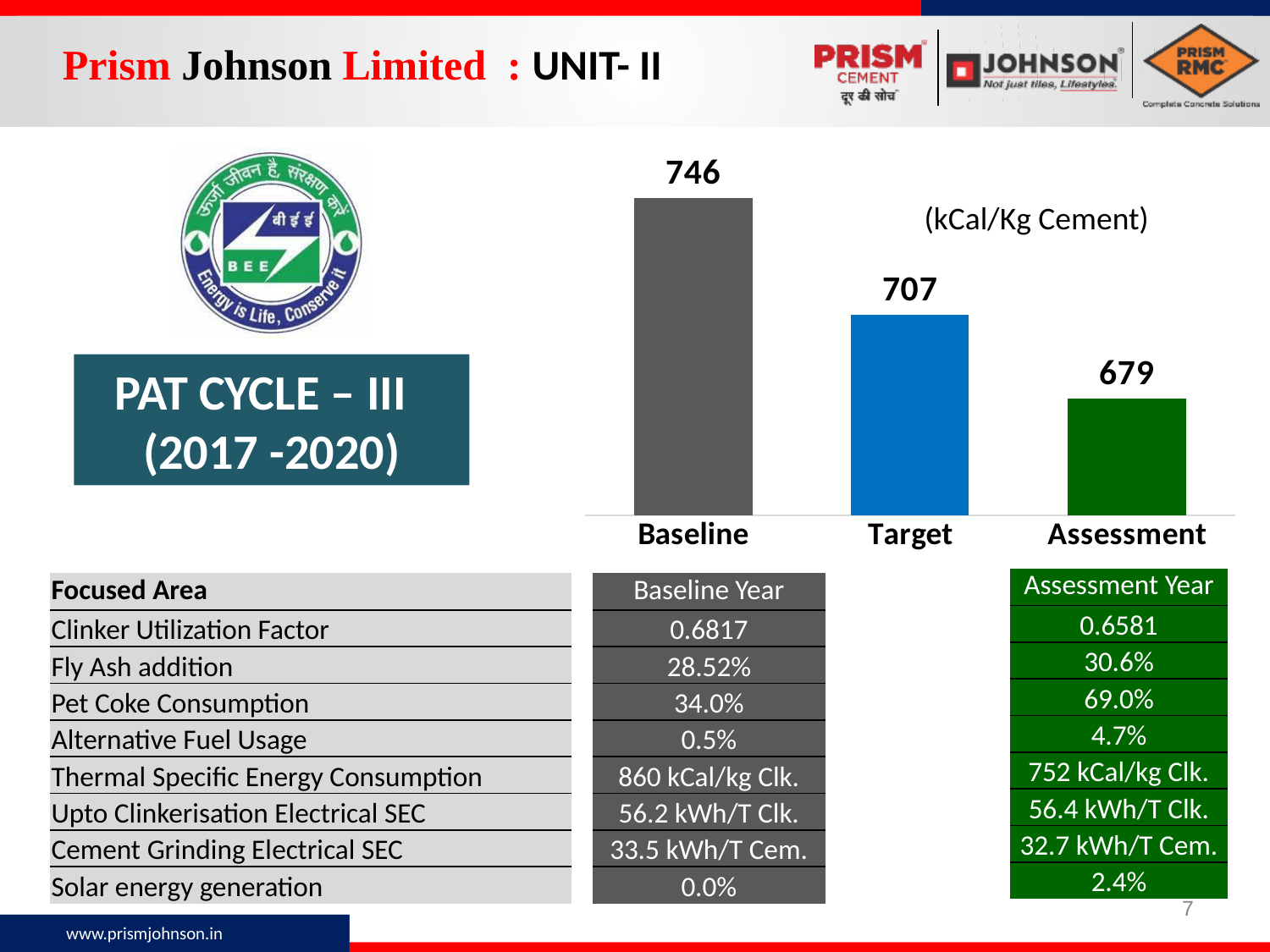
What is the value for Target in the bar chart? 707 How many bars are shown in the chart? 3 What is the value for Assessment in the bar chart? 679 What unit is shown next to the bar chart? kCal/Kg Cement What is the difference between the Baseline and Target values in the bar chart? 39 What is the value for Baseline in the bar chart? 746 Do the values in the bar chart rise or fall from Baseline to Assessment? Fall Which category has the lowest value in the bar chart? Assessment Which is larger in the bar chart, Target or Assessment? Target What is the difference between the Baseline and Assessment values in the bar chart? 67 What type of chart is shown on the slide? Bar chart Which category has the highest value in the bar chart? Baseline